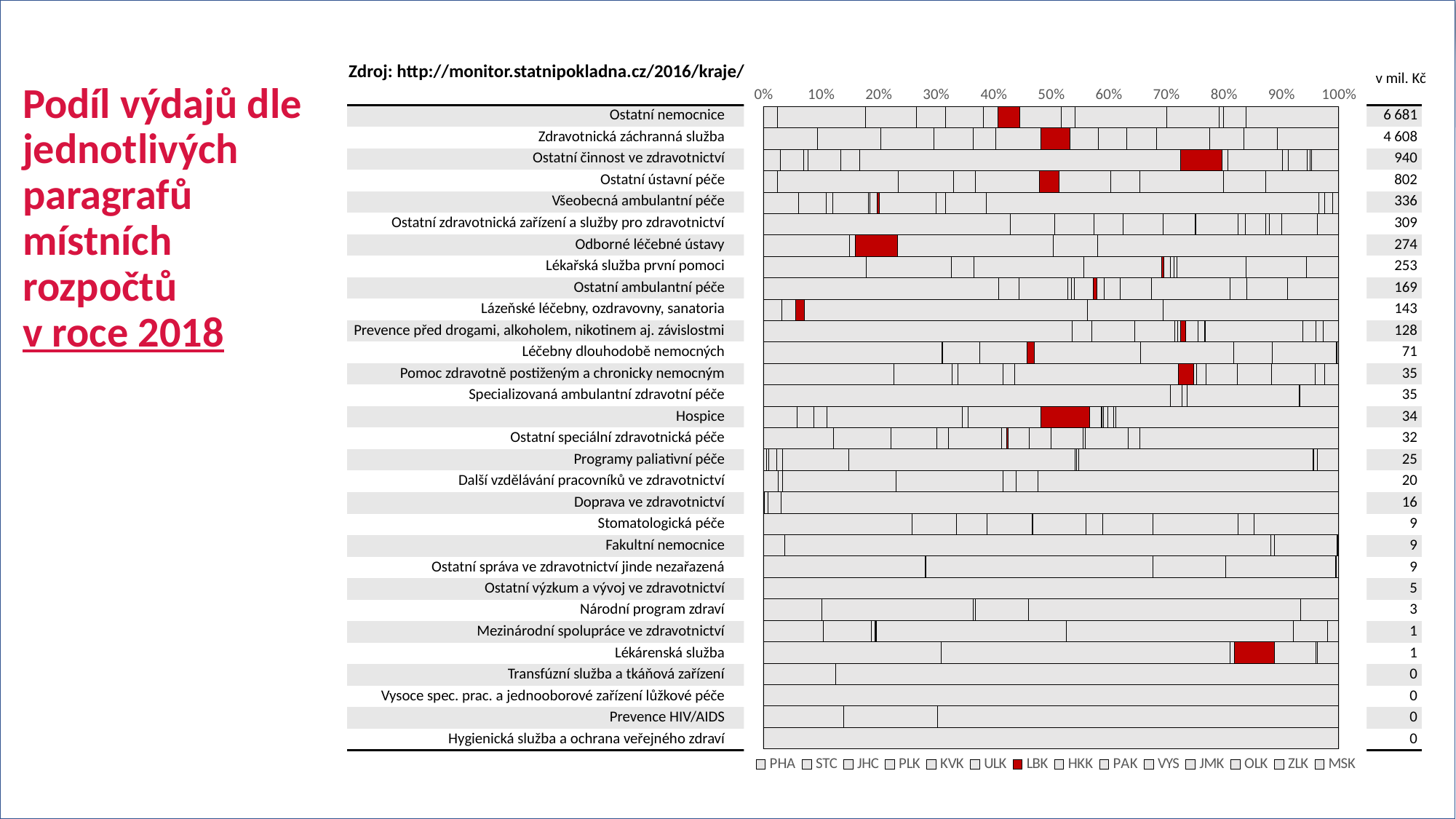
How many series does the legend list? 14 What is the value in mil. Kč shown for Hospice? 34 What is the value in mil. Kč shown for Ostatní nemocnice? 6 681 Which series is highlighted in red in the chart? LBK Which category has the highest value in mil. Kč? Ostatní nemocnice What is the value in mil. Kč shown for Odborné léčebné ústavy? 274 What is the source URL given above the chart? http://monitor.statnipokladna.cz/2016/kraje/ What kind of chart is shown on the slide? stacked bar chart How many categories (paragraphs) are plotted in the chart? 30 What is the difference in mil. Kč between Ostatní nemocnice and Zdravotnická záchranná služba? 2 073 What is the value in mil. Kč shown for Zdravotnická záchranná služba? 4 608 Which has a larger value in mil. Kč, Ostatní ústavní péče or Všeobecná ambulantní péče? Ostatní ústavní péče